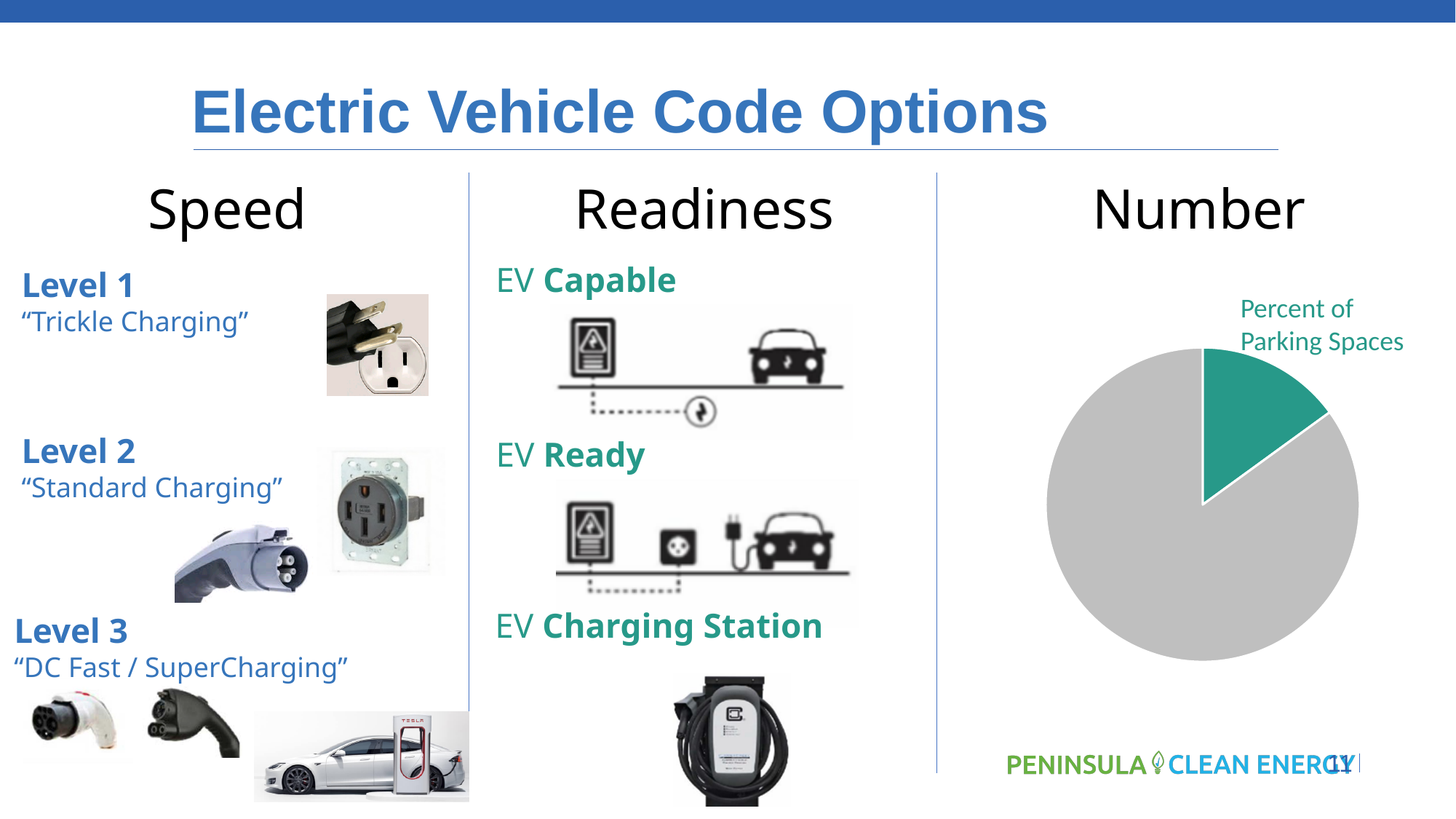
What label appears above the pie chart? Percent of Parking Spaces What colour is the smaller slice of the pie chart? teal How many slices does the pie chart have? 2 Which slice of the pie chart is the smallest? the teal slice What kind of chart is shown under the "Number" heading? pie chart Which slice of the pie chart is larger, the grey one or the teal one? the grey one